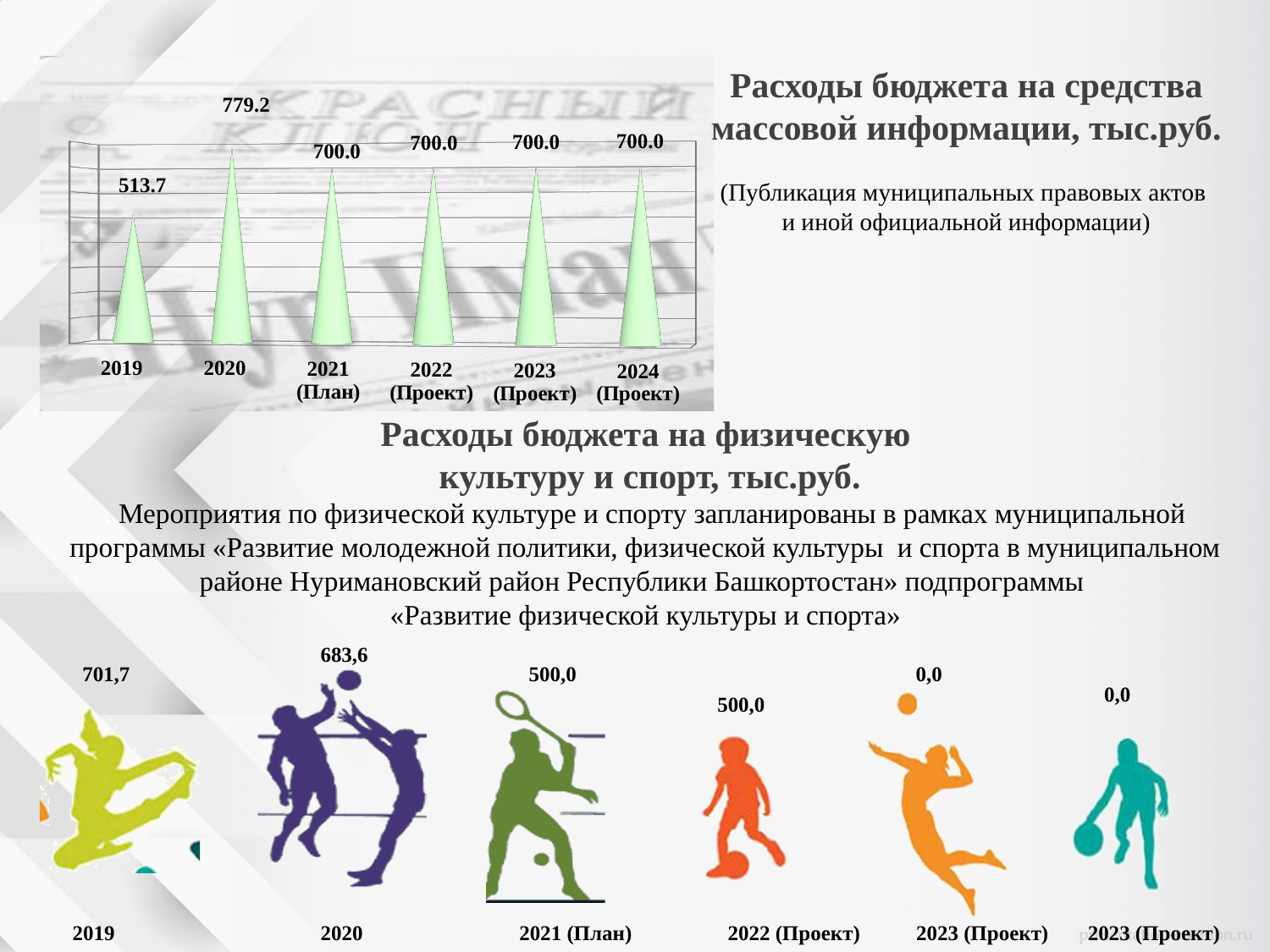
In the chart 'Расходы бюджета на средства массовой информации, тыс.руб.', what is the value for 2020? 779.2 What kind of chart is the chart 'Расходы бюджета на средства массовой информации, тыс.руб.'? bar chart In the chart 'Расходы бюджета на средства массовой информации, тыс.руб.', what is the difference between the values for 2020 and 2019? 265.5 In the chart 'Расходы бюджета на средства массовой информации, тыс.руб.', which year has the lowest value? 2019 In the chart 'Расходы бюджета на средства массовой информации, тыс.руб.', by how much does the 2020 value exceed the 2021 (План) value? 79.2 In the bottom infographic 'Расходы бюджета на физическую культуру и спорт, тыс.руб.', what is the value for 2020? 683,6 In the chart 'Расходы бюджета на средства массовой информации, тыс.руб.', what is the value for 2019? 513.7 How many years are shown in the chart 'Расходы бюджета на средства массовой информации, тыс.руб.'? 6 In the bottom infographic 'Расходы бюджета на физическую культуру и спорт, тыс.руб.', what is the value for 2019? 701,7 In the chart 'Расходы бюджета на средства массовой информации, тыс.руб.', which year has the highest value? 2020 In the chart 'Расходы бюджета на средства массовой информации, тыс.руб.', what is the value for 2021 (План)? 700.0 In the chart 'Расходы бюджета на средства массовой информации, тыс.руб.', which is larger: the value for 2019 or for 2021 (План)? 2021 (План)